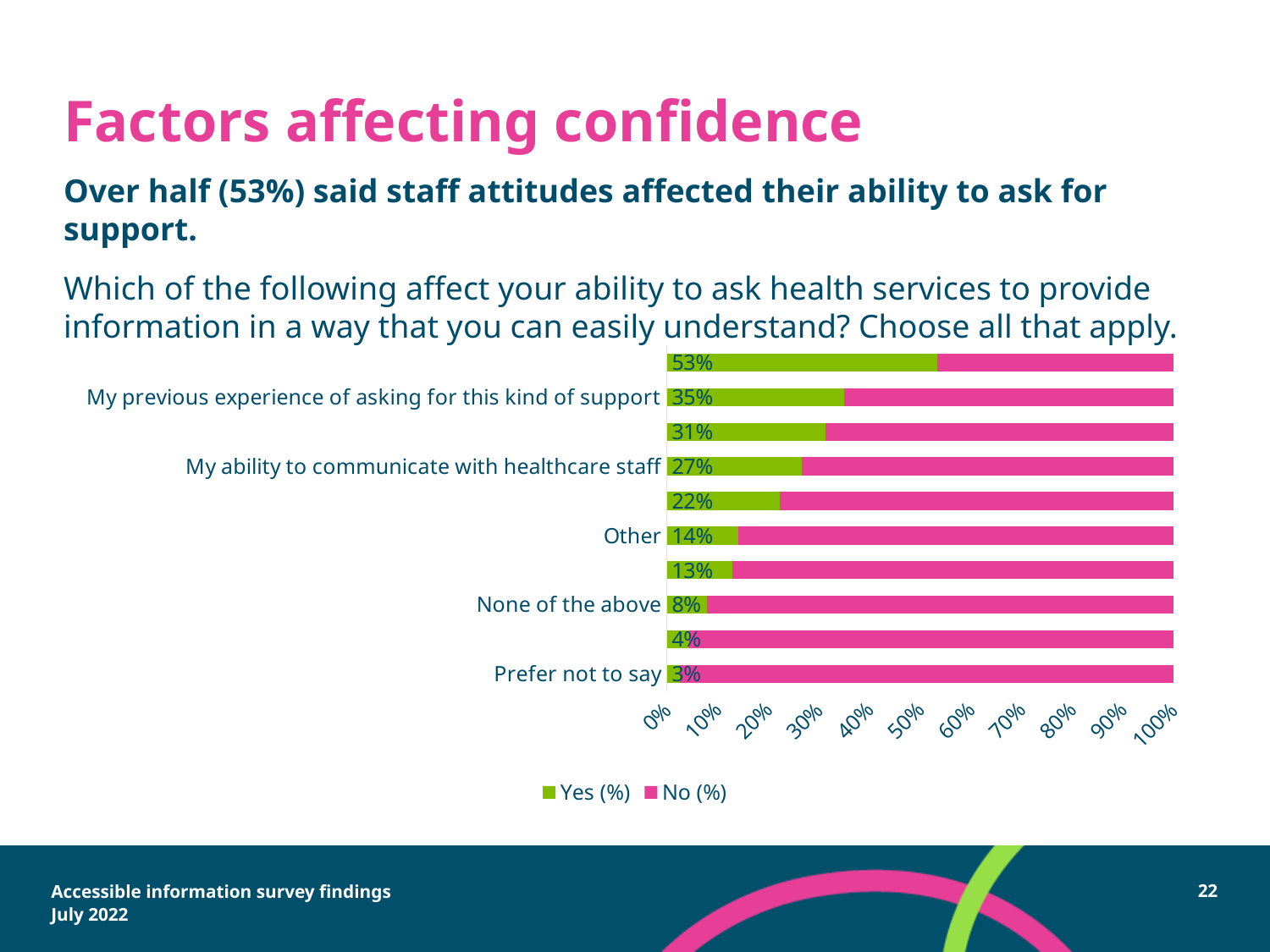
How many bars are plotted on the chart? 10 What kind of chart is shown on the slide? Stacked bar chart What is the Yes (%) value for "None of the above"? 8% What is the Yes (%) value for "Prefer not to say"? 3% What is the Yes (%) value for "My previous experience of asking for this kind of support"? 35% How many series does the legend list? 2 Which has a higher Yes (%) value: "Other" or "None of the above"? Other What is the highest Yes (%) value shown on the chart? 53% Which labelled category has the lowest Yes (%) value? Prefer not to say What is the Yes (%) value for "Other"? 14% What is the difference in Yes (%) between "My previous experience of asking for this kind of support" and "My ability to communicate with healthcare staff"? 8 percentage points What is the Yes (%) value for "My ability to communicate with healthcare staff"? 27%